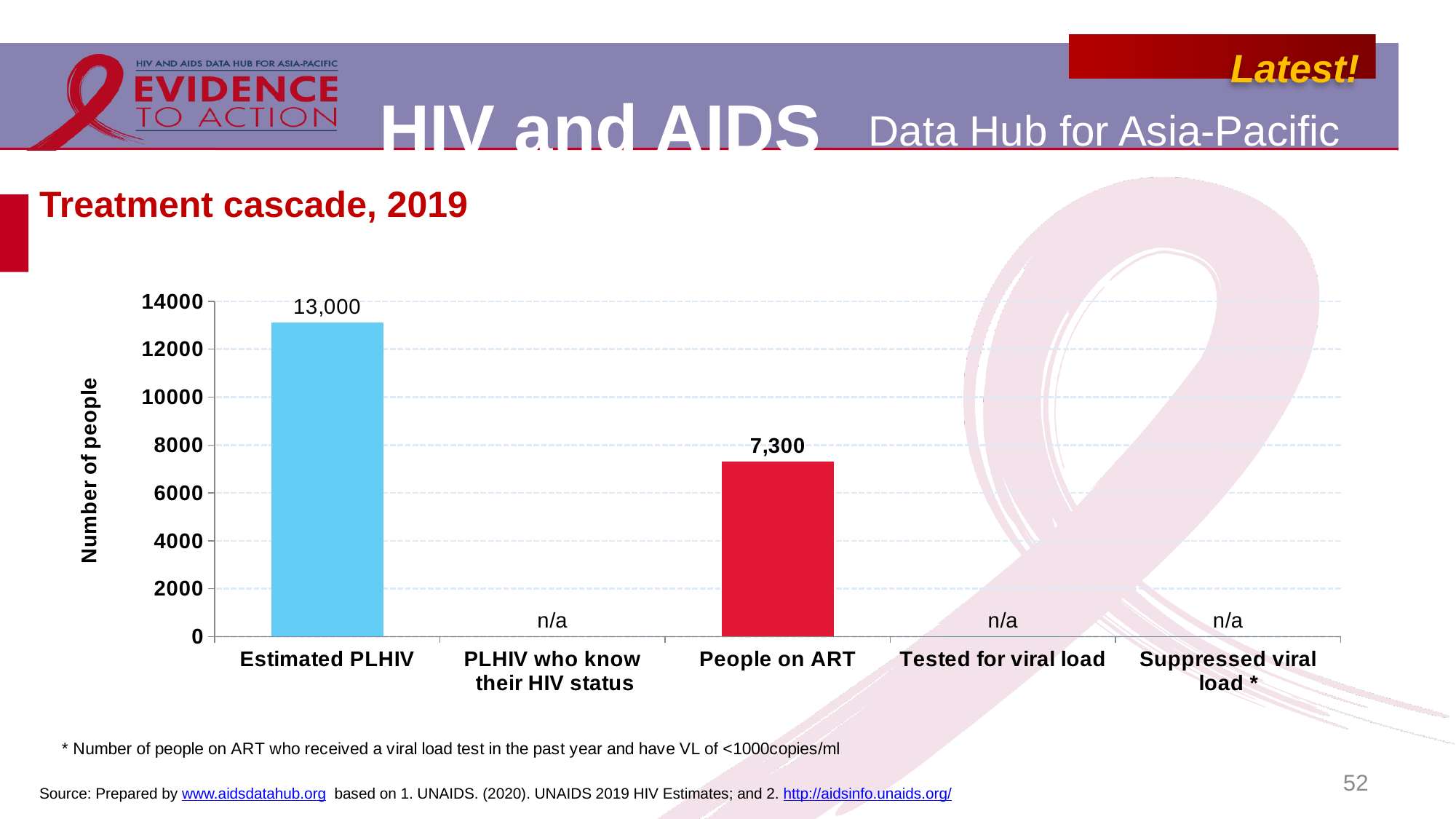
Which category has the highest value? Estimated PLHIV What kind of chart is this? bar chart What is shown for Suppressed viral load? n/a Is the value for People on ART greater or less than 8000? less What is the value for Estimated PLHIV? 13,000 What is the value for People on ART? 7,300 What is shown for PLHIV who know their HIV status? n/a How many categories are shown on the x axis? 5 What is the title of the chart? Treatment cascade, 2019 How many categories are labelled n/a? 3 What is the difference between Estimated PLHIV and People on ART? 5,700 Which is larger, Estimated PLHIV or People on ART? Estimated PLHIV